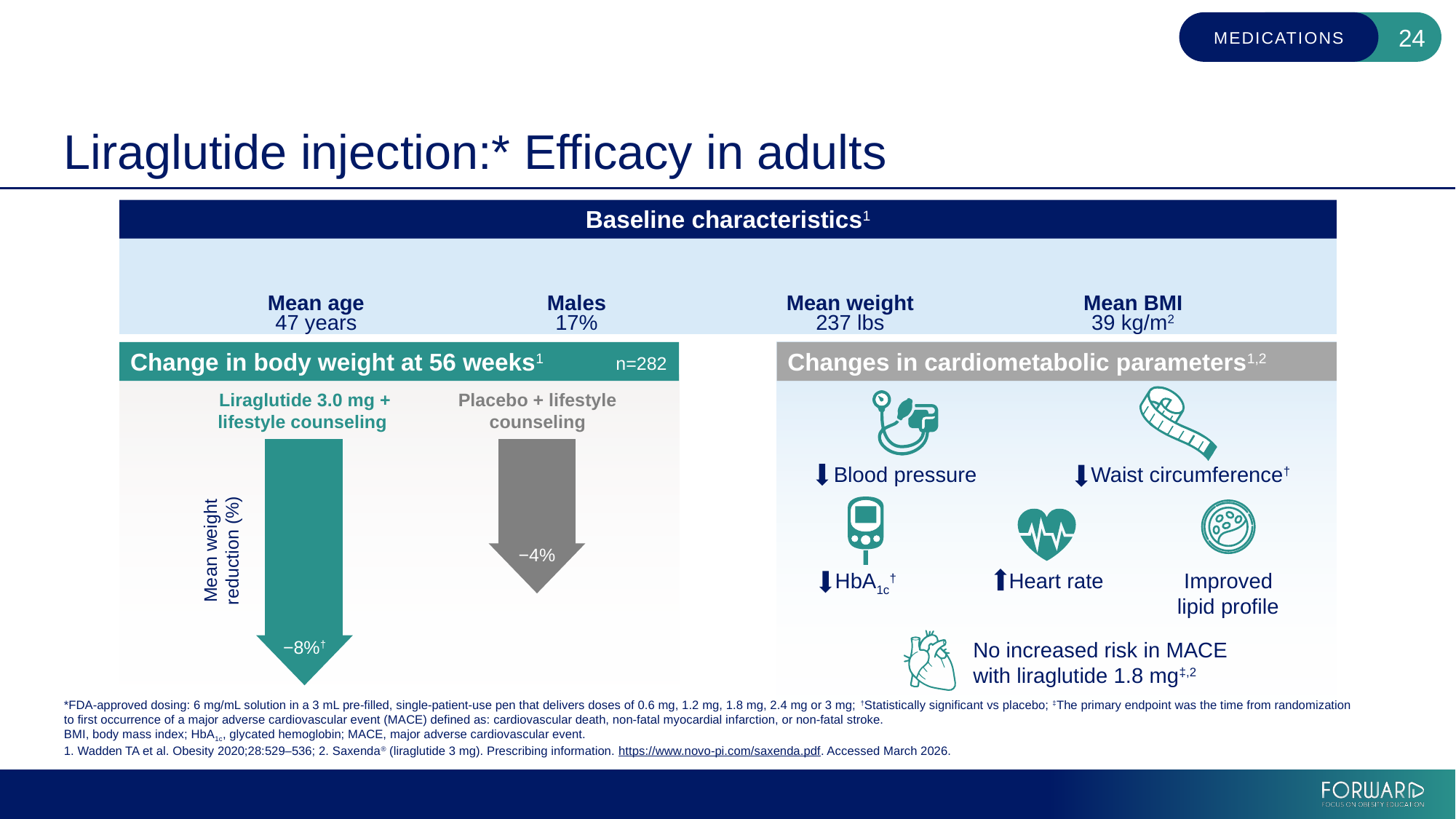
In the 'Change in body weight at 56 weeks' chart, by how many percentage points does the weight reduction for Liraglutide 3.0 mg + lifestyle counseling exceed that of Placebo + lifestyle counseling? 4 percentage points In the 'Change in body weight at 56 weeks' chart, which group shows the larger mean weight reduction? Liraglutide 3.0 mg + lifestyle counseling In the 'Change in body weight at 56 weeks' chart, is the weight reduction greater for the liraglutide group or the placebo group? Liraglutide group In the 'Change in body weight at 56 weeks' chart, which group shows the smaller mean weight reduction? Placebo + lifestyle counseling How many treatment groups are shown in the 'Change in body weight at 56 weeks' chart? 2 What is the sample size (n) shown in the header of the 'Change in body weight at 56 weeks' chart? n=282 In the 'Change in body weight at 56 weeks' chart, what is the mean weight reduction for Placebo + lifestyle counseling? −4% In the 'Change in body weight at 56 weeks' chart, what is the mean weight reduction for Liraglutide 3.0 mg + lifestyle counseling? −8% What is the vertical axis label of the 'Change in body weight at 56 weeks' chart? Mean weight reduction (%)